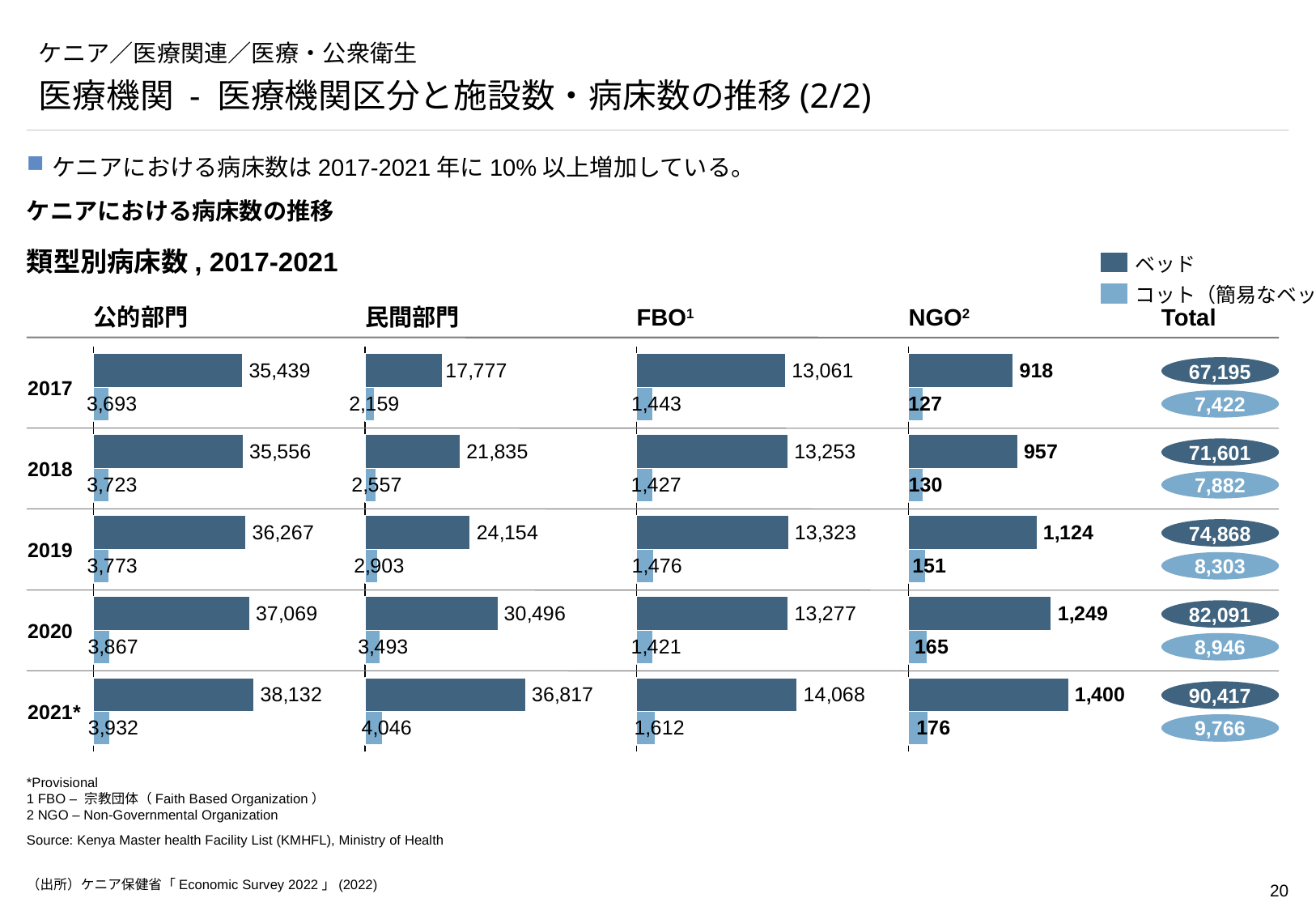
What kind of chart is used to show the number of beds and cots by sector? Bar chart What is the difference between the Total number of コット (cots) in 2021* and in 2020? 820 How many series does the legend list? 2 What is the number of ベッド (beds) in the 公的部門 (public sector) in 2017? 35,439 In which year is the number of コット (cots) for NGO lowest? 2017 Which is larger: the number of ベッド (beds) for FBO in 2019 or in 2020? 2019 What is the number of ベッド (beds) for NGO in 2019? 1,124 By how much did the number of ベッド (beds) in the 公的部門 (public sector) increase from 2017 to 2021*? 2,693 In which year is the number of ベッド (beds) in the 民間部門 (private sector) highest? 2021* What is the Total number of ベッド (beds) in 2020? 82,091 What is the number of コット (cots) in the 民間部門 (private sector) in 2021*? 4,046 How many years are shown in the chart? 5